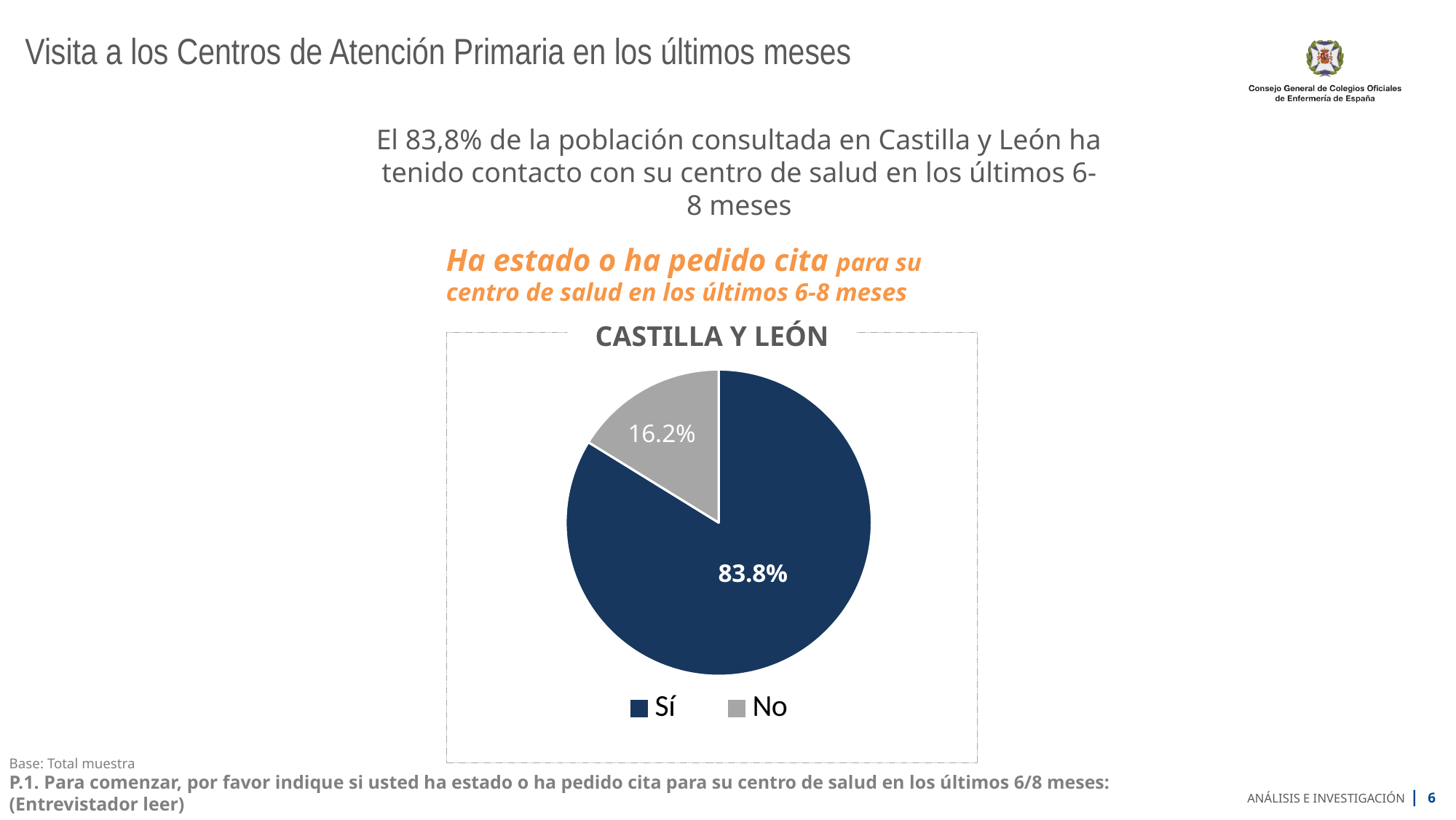
Which category has the largest share of the pie? Sí How many entries does the legend list? 2 What type of chart is shown on the slide? Pie chart What percentage of the pie corresponds to 'No'? 16.2% What colour is the 'No' slice in the pie chart? Grey How many slices does the pie chart have? 2 What is the title of the chart? CASTILLA Y LEÓN What percentage of the pie corresponds to 'Sí'? 83.8% What is the difference in percentage points between the 'Sí' and 'No' slices? 67.6 What share of the pie does the 'Sí' slice represent? 83.8% Which is larger, the 'Sí' slice or the 'No' slice? Sí Which category has the smallest share of the pie? No